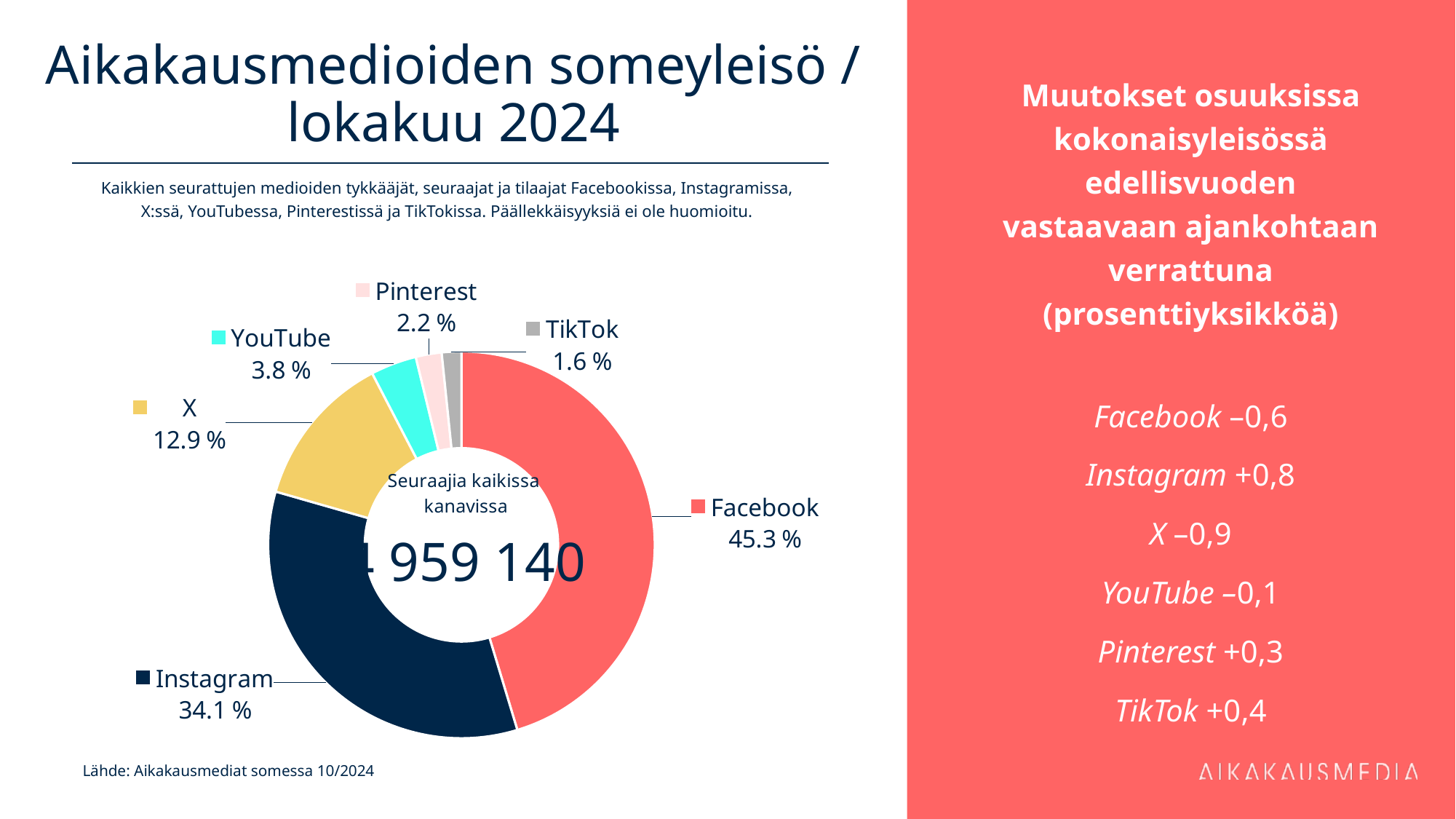
What is the combined share of Facebook and Instagram? 79.4 % Which platform has the smallest share of the audience? TikTok What share does TikTok hold in the donut chart? 1.6 % What type of chart is used on the slide? Donut (pie) chart Which has a larger share, YouTube or Pinterest? YouTube What share does X hold in the donut chart? 12.9 % How many platforms are shown in the donut chart? 6 What colour is the Instagram segment in the chart? Dark navy blue Which platform has the largest share of the audience? Facebook What share of the social media audience does Facebook hold? 45.3 % How many percentage points larger is Facebook's share than Instagram's? 11.2 What share of the social media audience does Instagram hold? 34.1 %